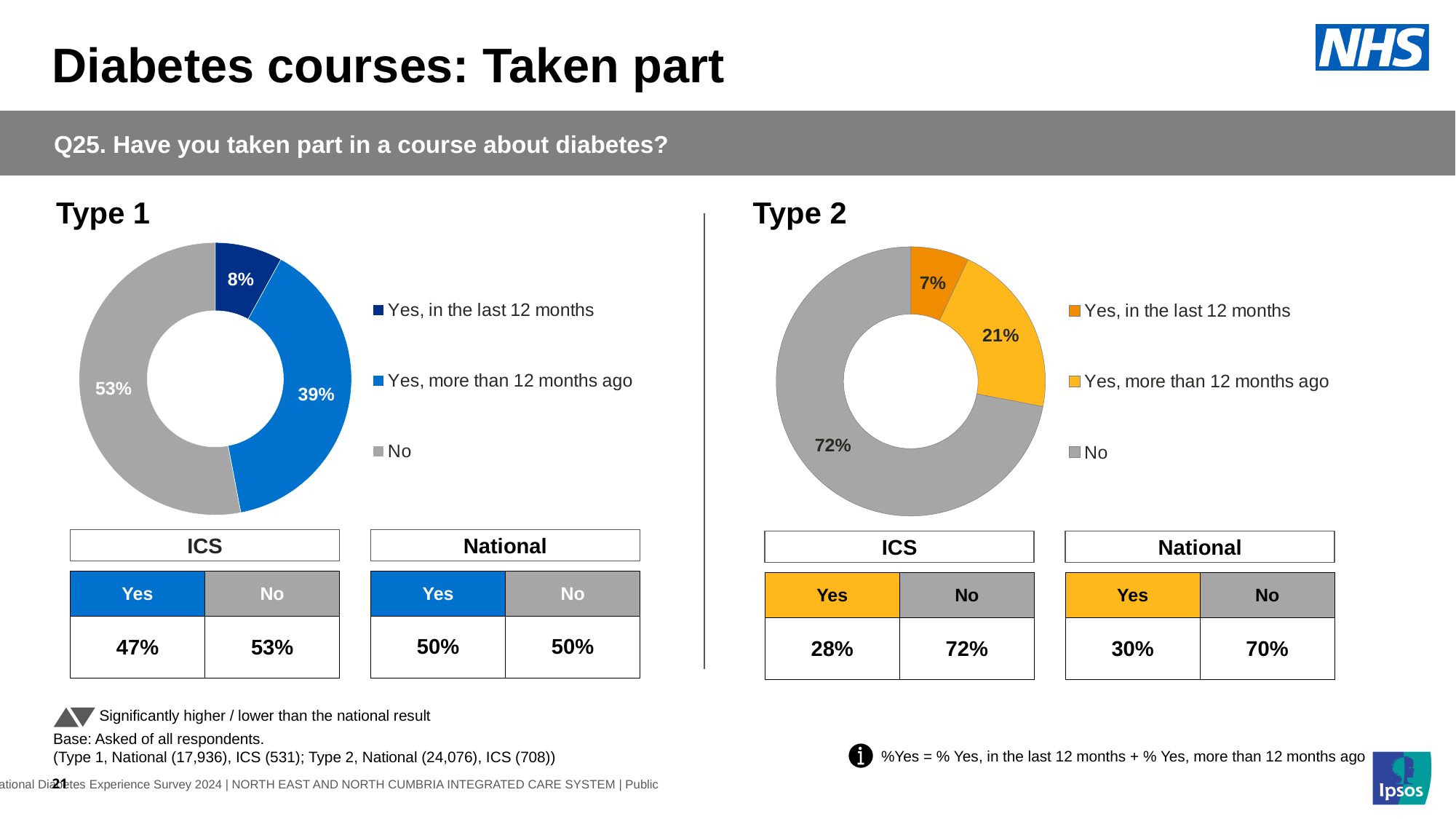
In the Type 1 chart, what is the combined share of the two 'Yes' categories? 47% How many categories does the Type 2 chart show? 3 How many legend entries does the Type 1 chart list? 3 In the Type 2 chart, what percentage of respondents answered 'Yes, more than 12 months ago'? 21% In the Type 1 chart, which category has the smallest share? Yes, in the last 12 months In the Type 2 chart, what colour is the 'No' segment? Grey In the Type 1 chart, what percentage of respondents answered 'Yes, in the last 12 months'? 8% What kind of chart is used for Type 1? Doughnut chart In the Type 1 chart, what percentage of respondents answered 'No'? 53% In the Type 2 chart, what is the difference between the 'No' share and the 'Yes, more than 12 months ago' share? 51% Which is larger in the Type 1 chart: 'Yes, more than 12 months ago' or 'Yes, in the last 12 months'? Yes, more than 12 months ago In the Type 2 chart, which category has the largest share? No